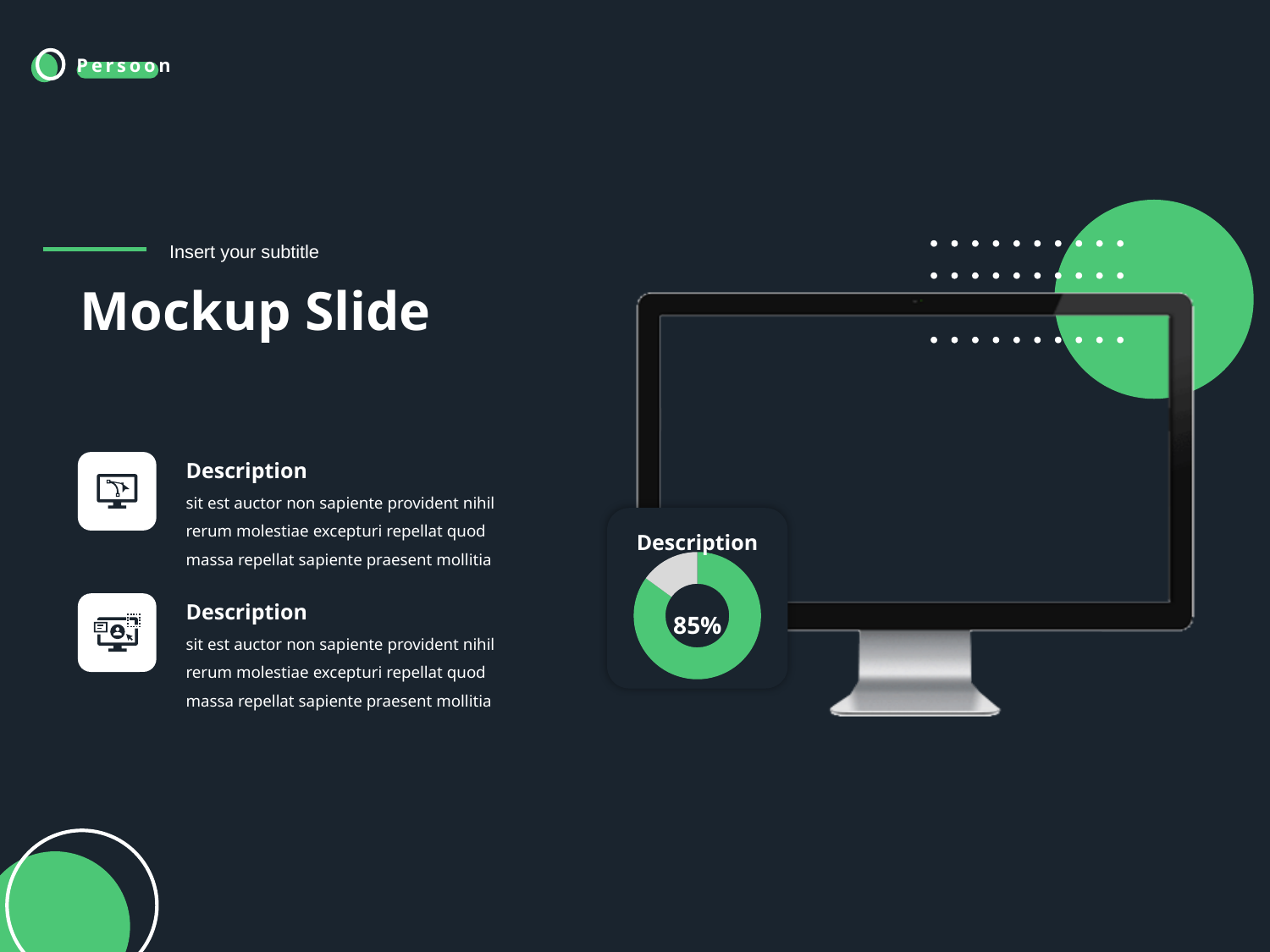
What type of chart is shown on the slide? Donut chart What is the title shown above the donut chart? Description Is the value shown in the donut chart greater or less than 50%? greater How many segments does the donut chart have? 2 Which colour fills the larger portion of the donut chart? Green Is the green portion of the donut chart larger or smaller than the grey portion? Larger What percentage is printed in the centre of the donut chart? 85%